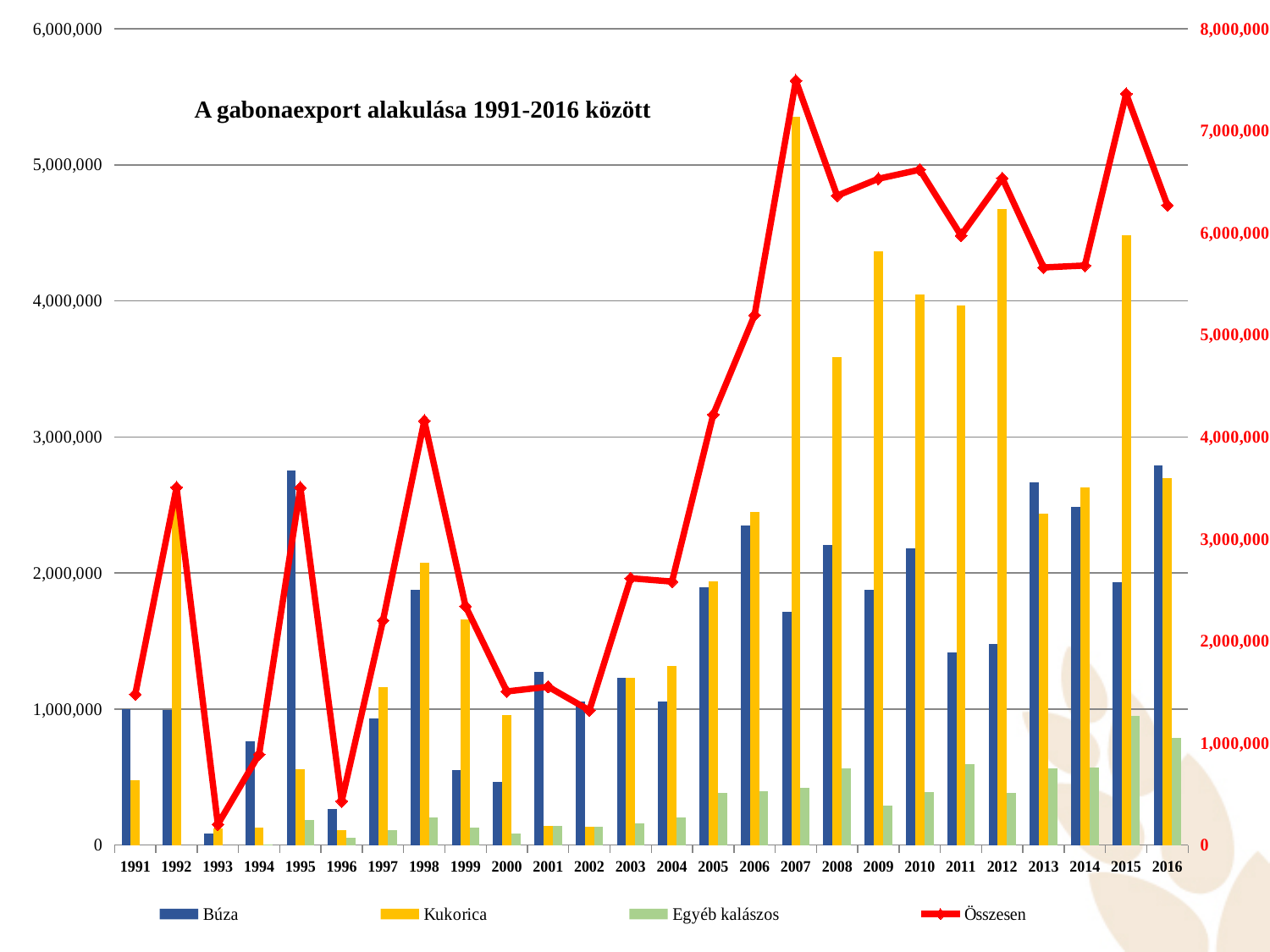
How many years are shown on the x axis? 26 In which year is the Búza value lowest? 1993 Is the Kukorica value for 2007 greater or less than 5,000,000? greater What kind of chart is this? A combined bar and line chart What is the title of the chart? A gabonaexport alakulása 1991-2016 között Is the Összesen value for 2007 greater or less than 7,000,000? greater Does the Összesen value rise or fall from 2004 to 2007? rise Which is larger in 2007, Búza or Kukorica? Kukorica How many series does the legend list? 4 In which year is the Összesen value lowest? 1993 In which year is the Kukorica value highest? 2007 Which series is plotted as a line rather than bars? Összesen